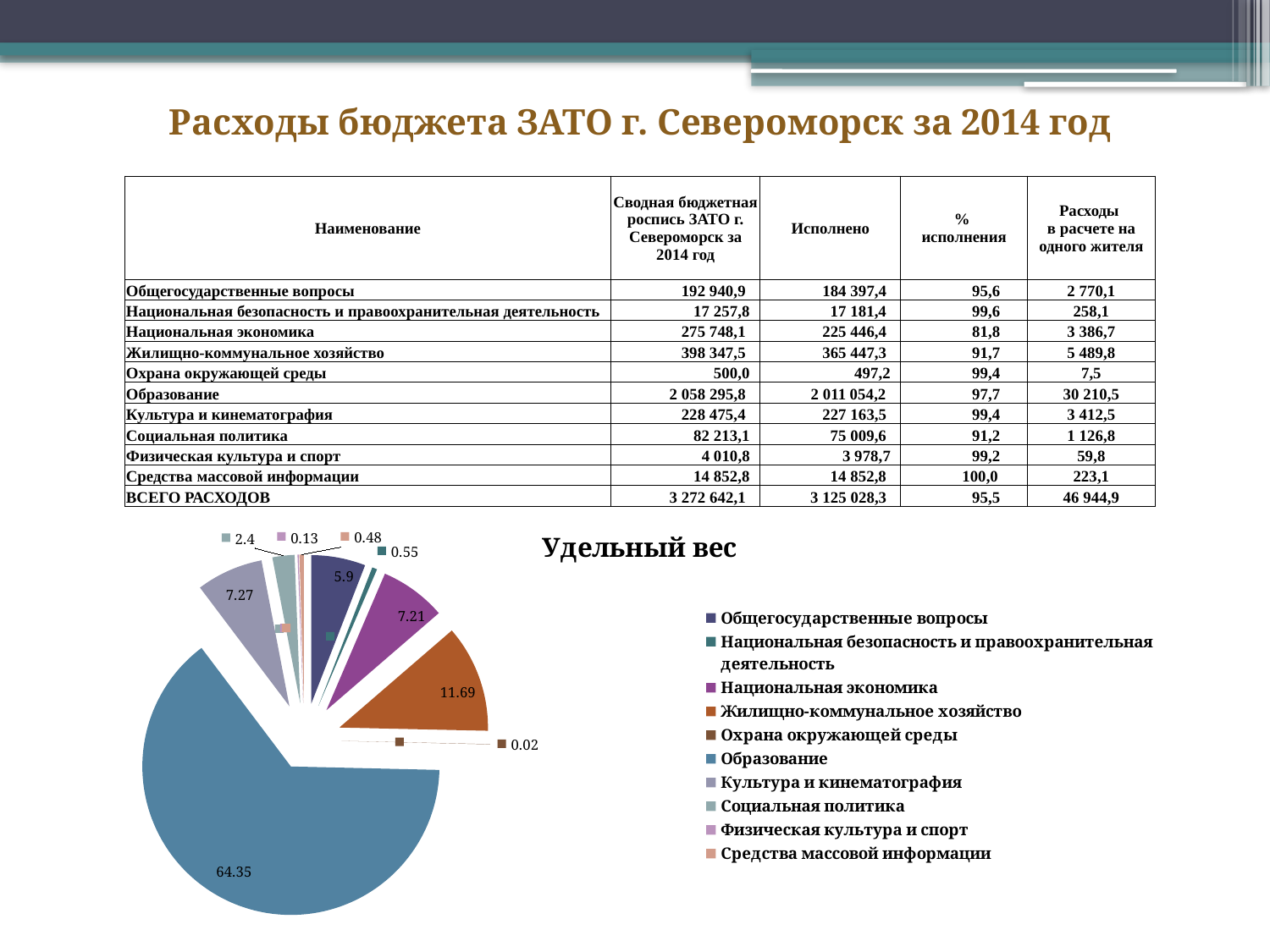
What kind of chart is shown under the table on the slide? pie chart In the pie chart, what is the value shown for Охрана окружающей среды? 0.02 In the pie chart, what is the value shown for Жилищно-коммунальное хозяйство? 11.69 In the pie chart, what is the value shown for Образование? 64.35 How many categories does the legend of the pie chart list? 10 Which category has the smallest slice in the pie chart? Охрана окружающей среды In the pie chart, what is the difference between the values for Жилищно-коммунальное хозяйство and Национальная экономика? 4.48 In the pie chart, what is the value shown for Социальная политика? 2.4 Which category has the largest slice in the pie chart? Образование In the pie chart, what is the value shown for Общегосударственные вопросы? 5.9 In the pie chart, which is larger: Национальная экономика or Жилищно-коммунальное хозяйство? Жилищно-коммунальное хозяйство What is the title of the pie chart? Удельный вес